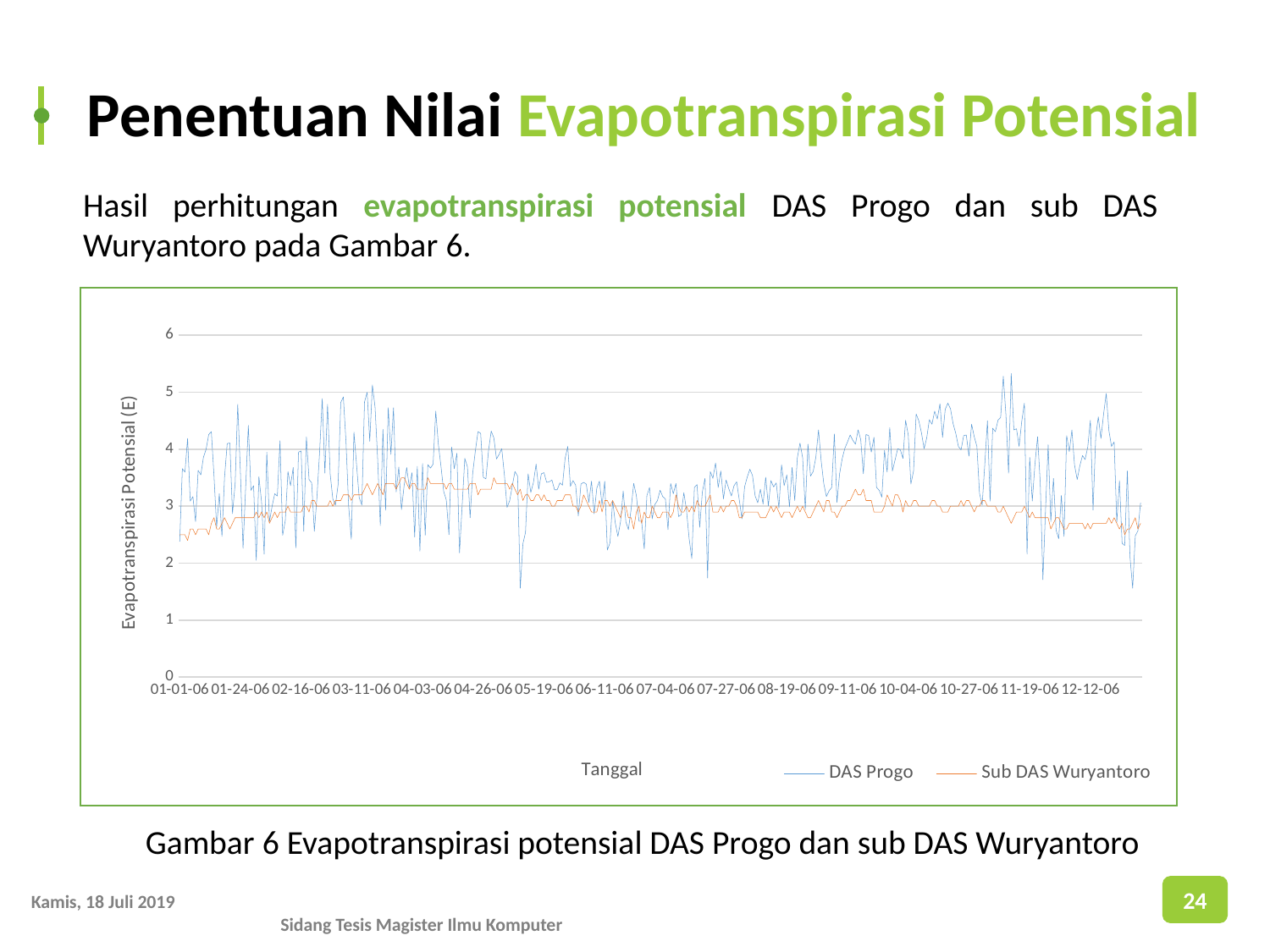
Is the highest value of the Sub DAS Wuryantoro series greater or less than 4? less Is the lowest value of the DAS Progo series greater or less than 2? less Which series shows the lower and more stable values across the year? Sub DAS Wuryantoro How many series does the chart legend list? 2 What is the title of the y axis? Evapotranspirasi Potensial (E) Is the lowest value of the Sub DAS Wuryantoro series greater or less than 2? greater Which series has the larger peak value, DAS Progo or Sub DAS Wuryantoro? DAS Progo How many date labels are shown along the x axis? 16 Which series reaches the highest values on the chart? DAS Progo What kind of chart is shown on the slide? line chart What is the title of the x axis? Tanggal